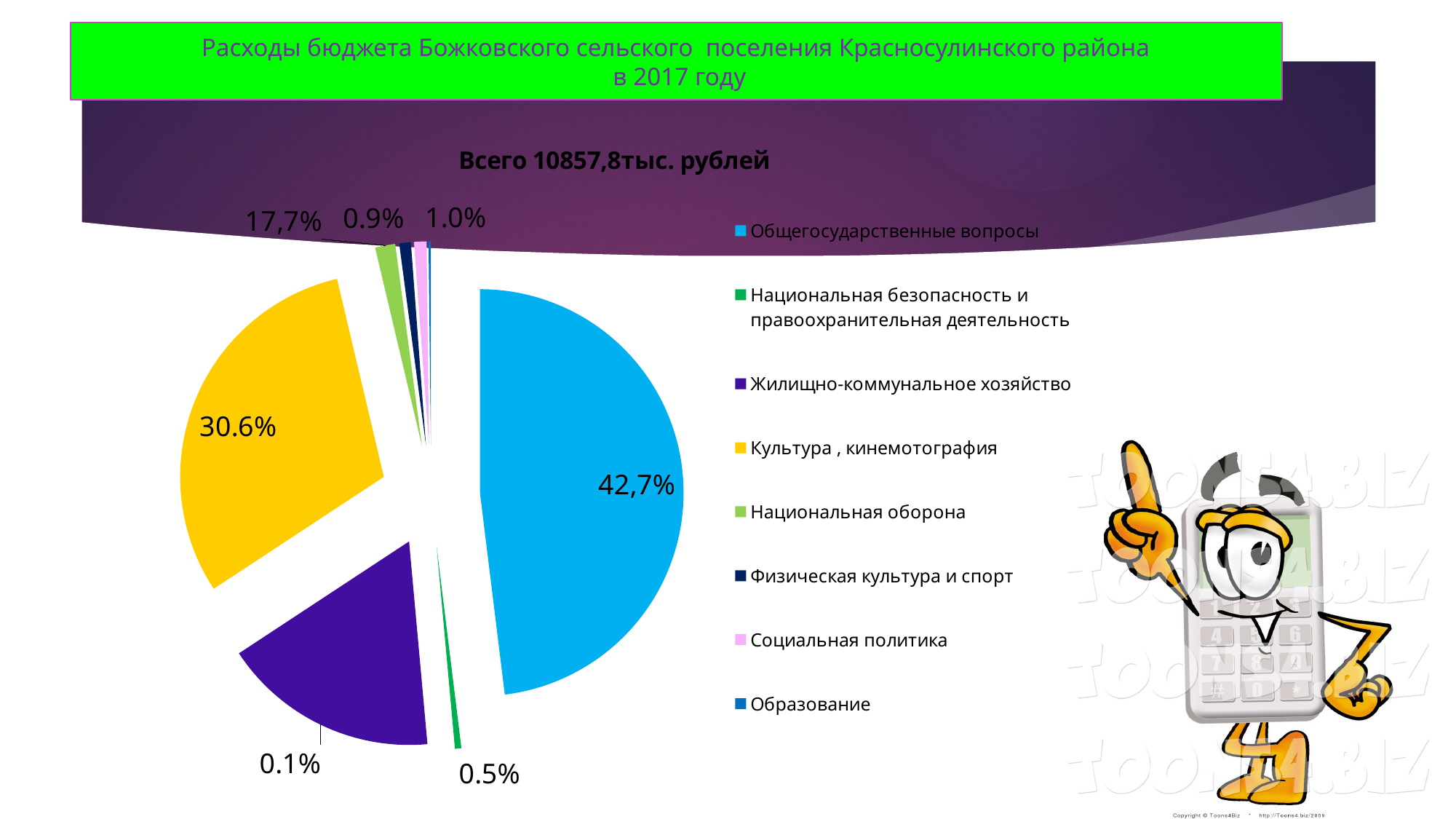
Which slice is larger: Жилищно-коммунальное хозяйство or Национальная оборона? Жилищно-коммунальное хозяйство What share of the budget expenditure is labelled for Культура, кинемотография? 30.6% What share of the budget expenditure is labelled for Общегосударственные вопросы? 42,7% Which slice is larger: Общегосударственные вопросы or Культура, кинемотография? Общегосударственные вопросы How many categories does the legend of the pie chart list? 8 What kind of chart is shown on the slide? pie chart Which category has the largest slice of the pie? Общегосударственные вопросы What total amount of expenditure is stated above the pie chart? 10857,8тыс. рублей Which slice is larger: Культура, кинемотография or Жилищно-коммунальное хозяйство? Культура, кинемотография Which year does the chart title say the budget expenditure refers to? 2017